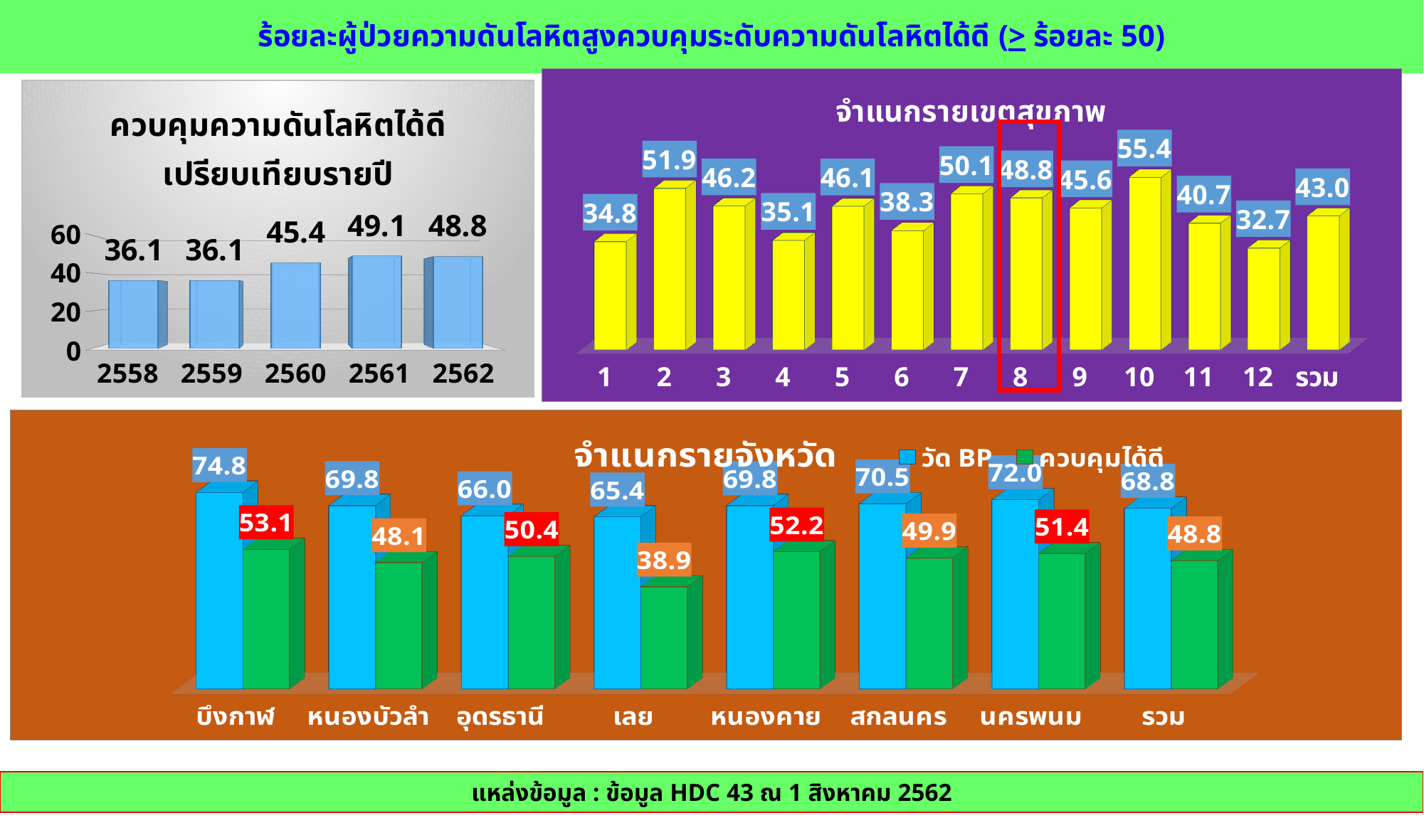
In the bottom chart (จำแนกรายจังหวัด), what is the difference between the วัด BP and ควบคุมได้ดี values for นครพนม? 20.6 In the bottom chart (จำแนกรายจังหวัด), how many series does the legend list? 2 In the top-right chart (จำแนกรายเขตสุขภาพ), which region has the highest value? 10 In the top-right chart (จำแนกรายเขตสุขภาพ), what is the value for รวม? 43.0 In the bottom chart (จำแนกรายจังหวัด), which province has the highest วัด BP value? บึงกาฬ In the top-left chart (ควบคุมความดันโลหิตได้ดี เปรียบเทียบรายปี), how many years are shown? 5 In the top-right chart (จำแนกรายเขตสุขภาพ), which region has the lowest value? 12 In the top-right chart (จำแนกรายเขตสุขภาพ), what is the value for region 8? 48.8 In the top-left chart (ควบคุมความดันโลหิตได้ดี เปรียบเทียบรายปี), what is the value for 2560? 45.4 In the bottom chart (จำแนกรายจังหวัด), what is the ควบคุมได้ดี value for เลย? 38.9 In the top-left chart (ควบคุมความดันโลหิตได้ดี เปรียบเทียบรายปี), which year has the highest value? 2561 In the top-left chart (ควบคุมความดันโลหิตได้ดี เปรียบเทียบรายปี), what is the difference between the values for 2561 and 2558? 13.0